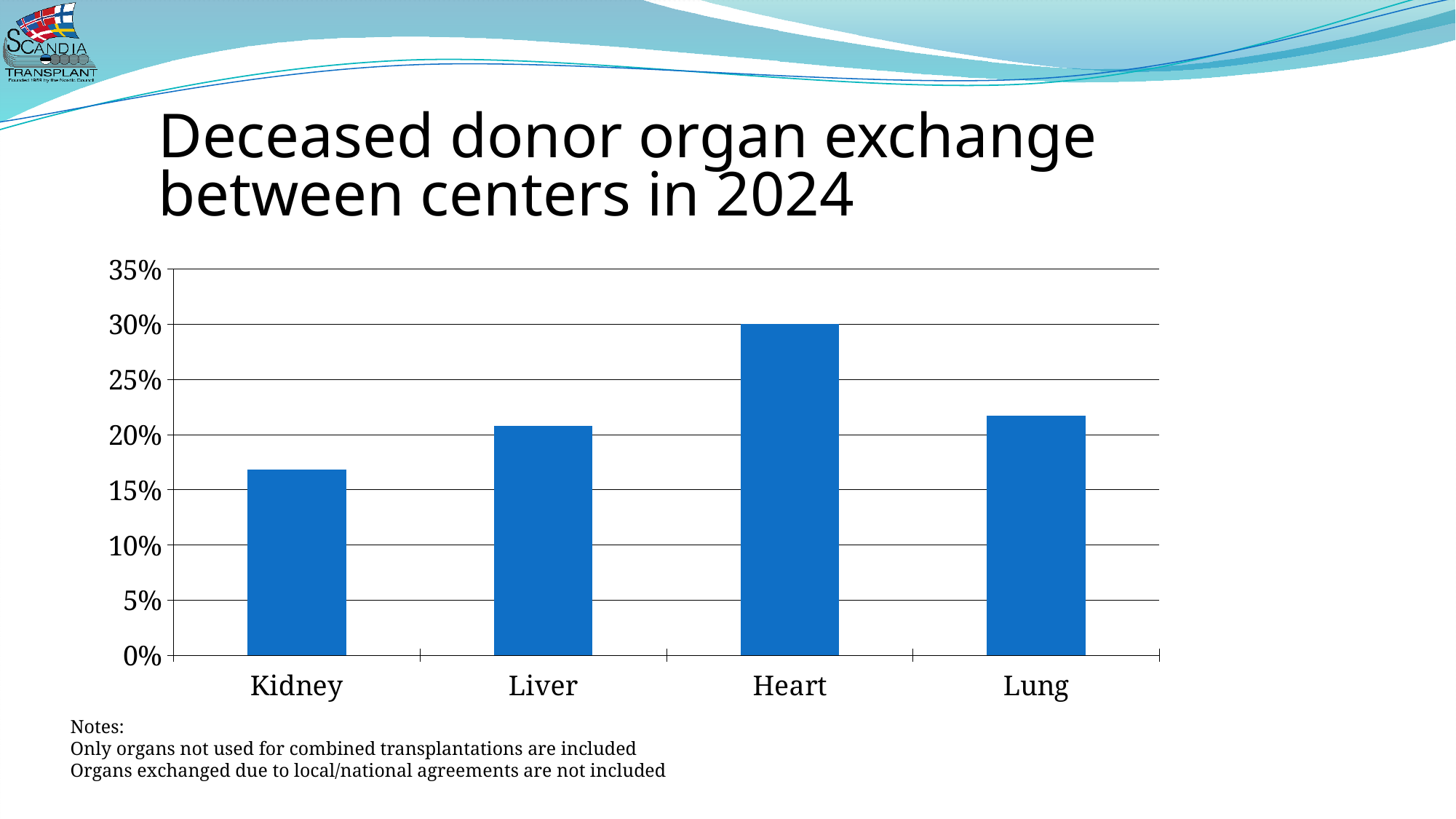
Is the value for Kidney greater or less than 15%? greater Which is larger, the value for Heart or the value for Lung? Heart What type of chart is shown on the slide? bar chart Is the value for Heart greater or less than 25%? greater How many organ categories are shown on the x axis? 4 Is the value for Kidney greater or less than 20%? less Which organ has the highest exchange percentage? Heart What is the title of the slide containing the chart? Deceased donor organ exchange between centers in 2024 Which organ has the lowest exchange percentage? Kidney Which is larger, the value for Kidney or the value for Liver? Liver